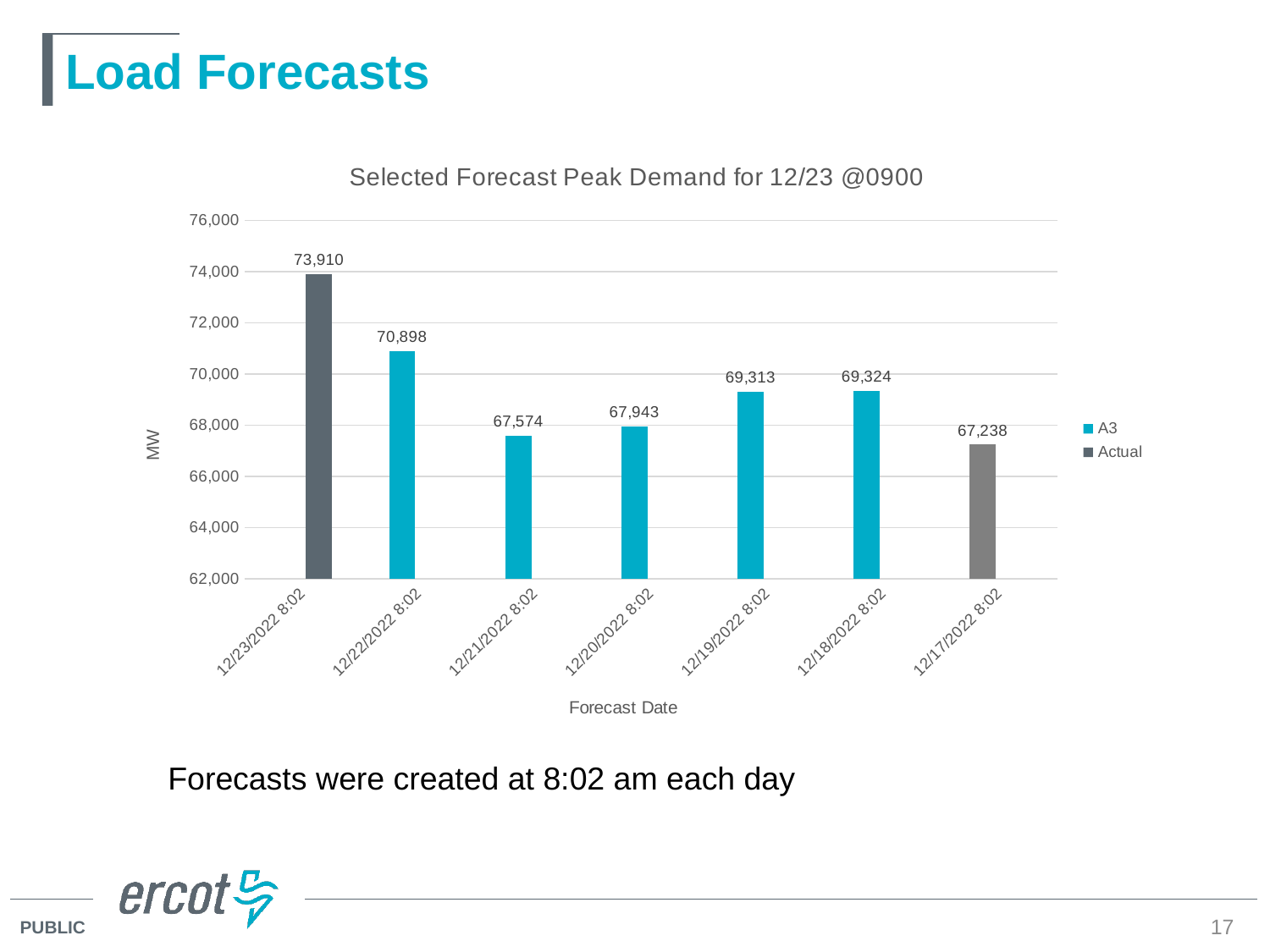
Which is larger, the value for 12/20/2022 8:02 or the value for 12/21/2022 8:02? 12/20/2022 8:02 Which forecast date has the lowest value? 12/17/2022 8:02 Which forecast date has the highest value? 12/23/2022 8:02 What is the value for 12/23/2022 8:02? 73,910 Is the value for 12/19/2022 8:02 greater or less than 70,000? less What kind of chart is shown on the slide? bar chart What is the value for 12/22/2022 8:02? 70,898 What is the difference between the values for 12/23/2022 8:02 and 12/22/2022 8:02? 3,012 How many series does the legend list? 2 How many forecast dates are shown on the x axis? 7 What is the value for 12/17/2022 8:02? 67,238 What is the value for 12/21/2022 8:02? 67,574